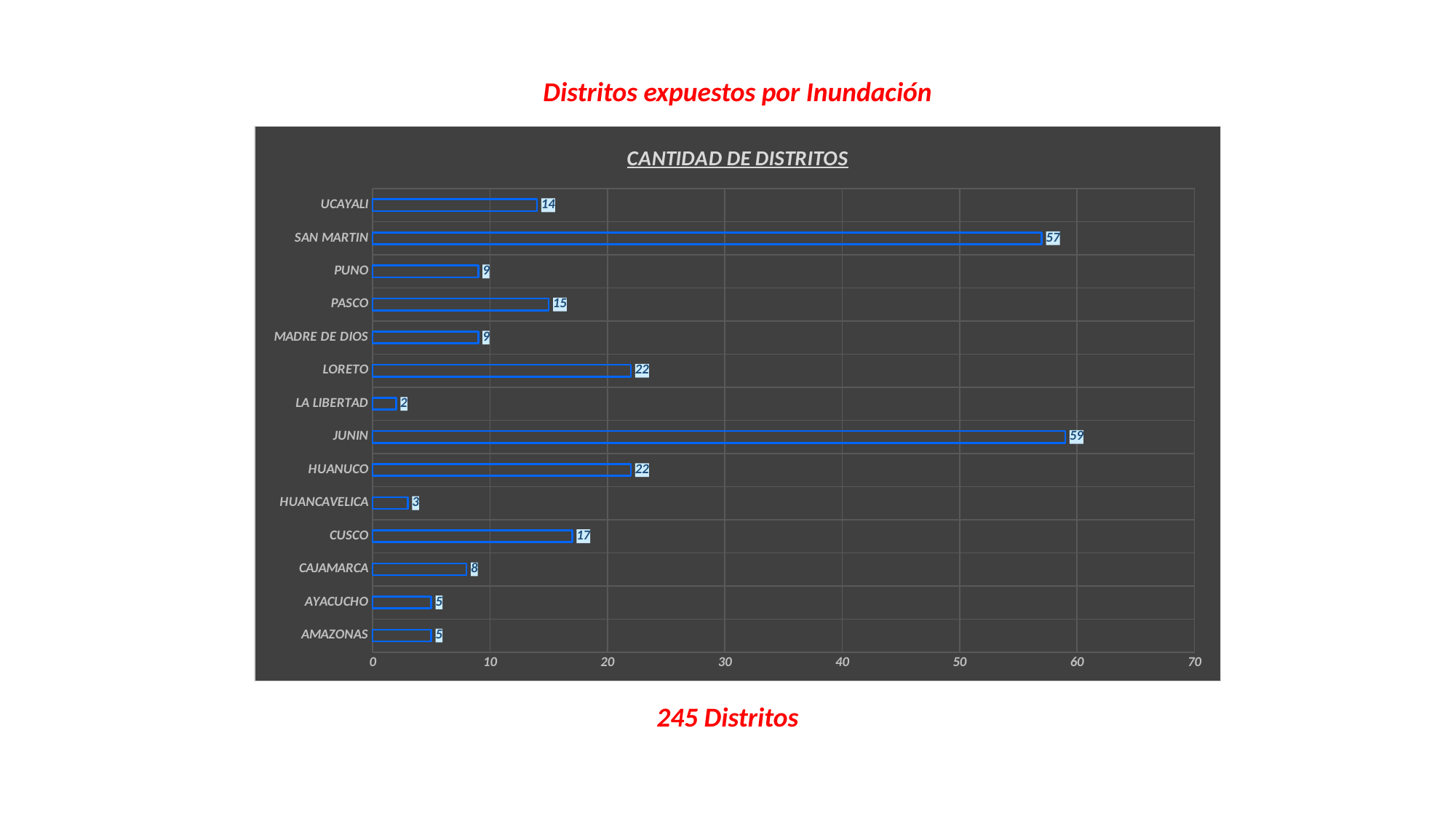
How many categories are shown in the chart? 14 What is the value for LA LIBERTAD? 2 Which category has the lowest value? LA LIBERTAD Which is larger, the value for CUSCO or the value for PASCO? CUSCO What is the value for LORETO? 22 What is the value for SAN MARTIN? 57 What kind of chart is shown on the slide? Bar chart What is the title of the chart? CANTIDAD DE DISTRITOS Is the value for HUANUCO greater or less than 20? greater What is the difference between the values for JUNIN and SAN MARTIN? 2 Which category has the highest value? JUNIN What is the difference between the values for CUSCO and CAJAMARCA? 9